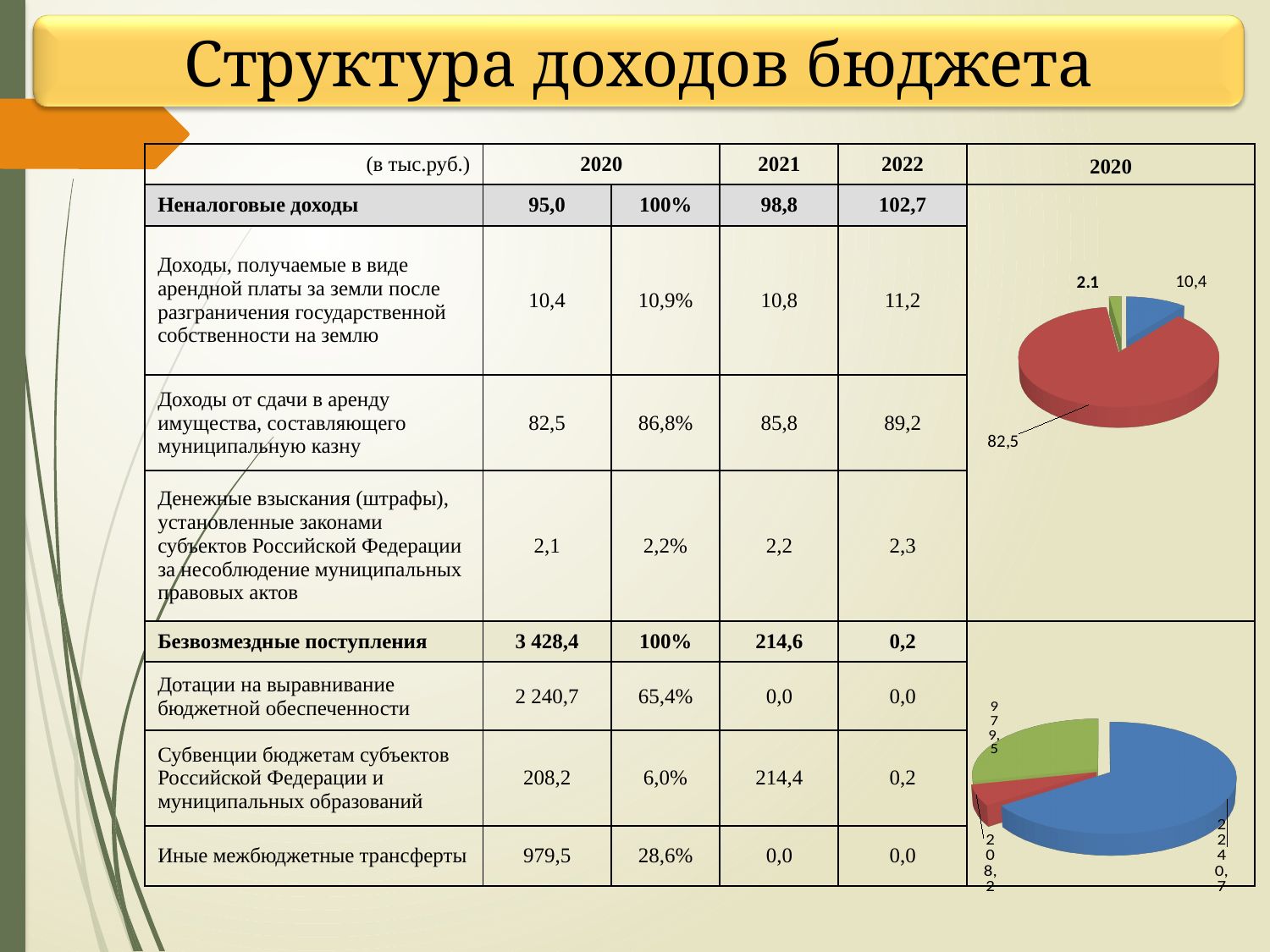
In the upper pie chart (2020), which slice is larger: the red one or the blue one? the red one In the upper pie chart (2020), what is the difference between the slice labelled 82,5 and the slice labelled 10,4? 72,1 In the lower pie chart, what is the value of the largest slice? 2 240,7 In the upper pie chart (2020), what share of the total does the slice labelled 82,5 represent? 86,8% In the lower pie chart, what is the value of the smallest slice? 208,2 How many slices does the lower pie chart have? 3 How many slices does the upper pie chart (2020) have? 3 In the upper pie chart (2020), what is the value of the smallest slice? 2.1 What kind of chart is the upper chart on the right of the slide? pie chart What title is shown above the upper pie chart? 2020 In the upper pie chart (2020), what is the value of the largest slice? 82,5 What kind of chart is the lower chart on the right of the slide? pie chart